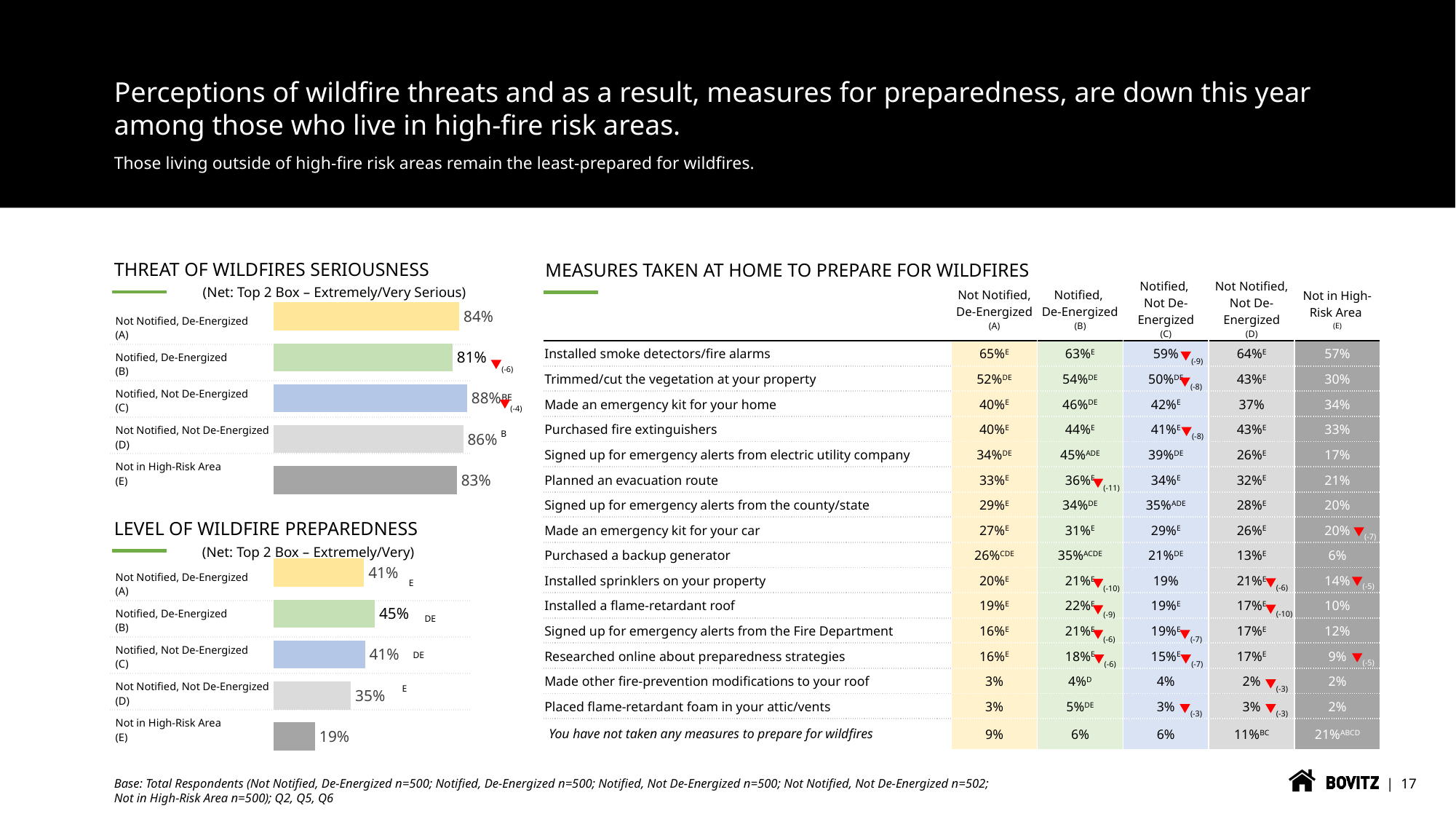
In the Threat of Wildfires Seriousness chart, what is the difference between Notified, Not De-Energized (C) and Not in High-Risk Area (E)? 5 percentage points In the Level of Wildfire Preparedness chart, which category has the lowest value? Not in High-Risk Area (E) In the Threat of Wildfires Seriousness chart, how many categories are shown? 5 In the Level of Wildfire Preparedness chart, which is larger: Not Notified, De-Energized (A) or Not Notified, Not De-Energized (D)? Not Notified, De-Energized (A) What kind of chart is the Level of Wildfire Preparedness chart? Bar chart In the Threat of Wildfires Seriousness chart, which category has the lowest value? Notified, De-Energized (B) What is the subtitle shown under the Threat of Wildfires Seriousness chart title? (Net: Top 2 Box – Extremely/Very Serious) In the Threat of Wildfires Seriousness chart, which category has the highest value? Notified, Not De-Energized (C) In the Level of Wildfire Preparedness chart, which category has the highest value? Notified, De-Energized (B) In the Level of Wildfire Preparedness chart, what is the difference between Notified, De-Energized (B) and Not Notified, Not De-Energized (D)? 10 percentage points In the Level of Wildfire Preparedness chart, what is the value for Not in High-Risk Area (E)? 19% In the Threat of Wildfires Seriousness chart, what is the value for Not Notified, De-Energized (A)? 84%